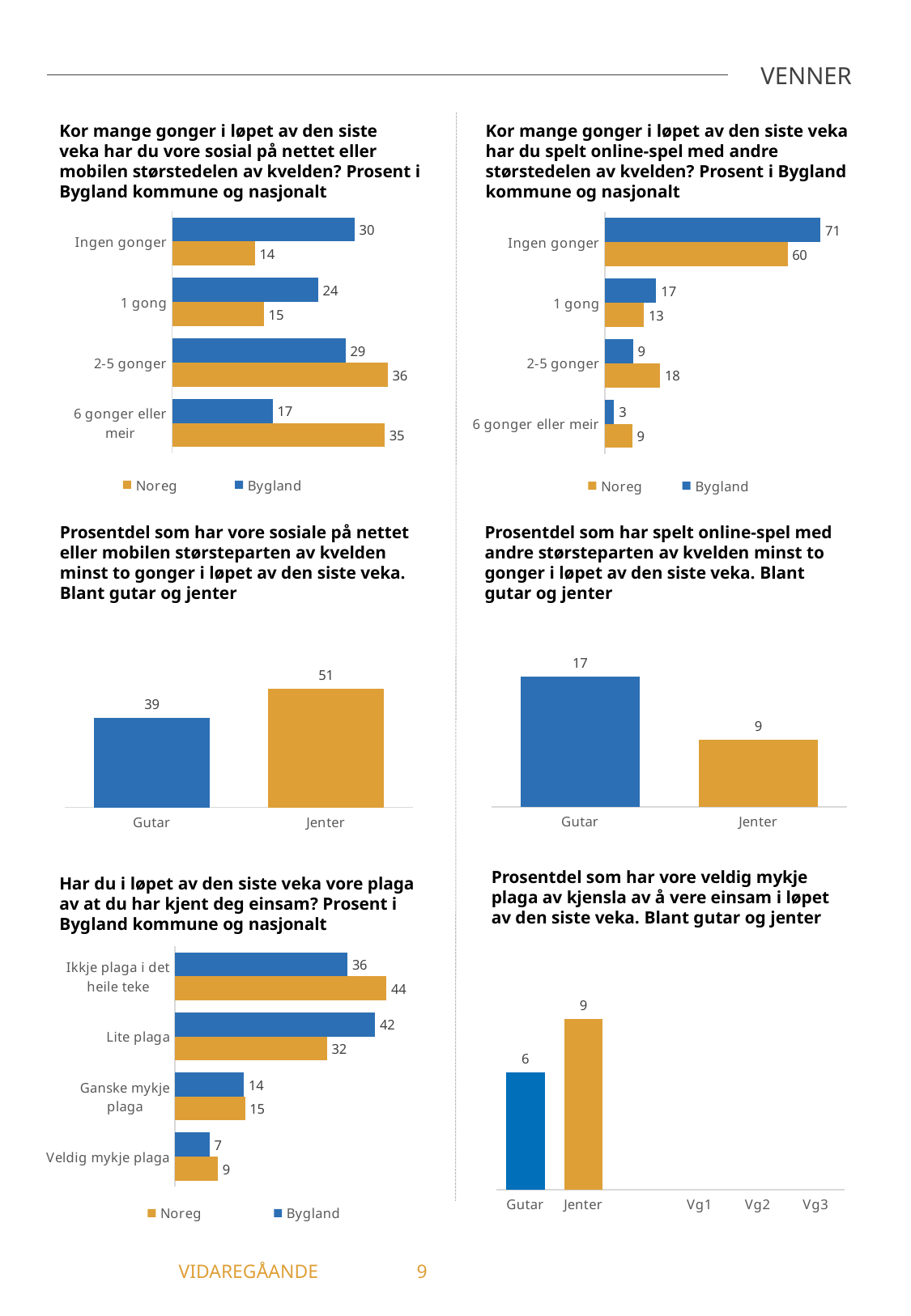
In the bottom-left chart about feeling lonely, how many series does the legend list? 2 In the bottom-left chart about feeling lonely, how many categories are shown? 4 In the top-left chart about being social online or on the phone, what is the value for Bygland for 'Ingen gonger'? 30 In the middle-right chart about playing online games at least twice in the last week, which group has the lower value? Jenter In the top-right chart about playing online games, what is the difference between the Bygland and Noreg values for 'Ingen gonger'? 11 In the bottom-left chart about feeling lonely, what is the value for Bygland for 'Lite plaga'? 42 In the bottom-right chart about being very much bothered by loneliness, what is the difference between Jenter and Gutar? 3 What kind of chart is the top-left chart about being social online or on the phone? Bar chart In the top-right chart about playing online games, which category has the highest value for Bygland? Ingen gonger In the middle-left chart about being social online at least twice in the last week, what is the value for Jenter? 51 In the top-left chart about being social online or on the phone, what is the value for Noreg for '6 gonger eller meir'? 35 In the top-right chart about playing online games, which is larger for '2-5 gonger': Noreg or Bygland? Noreg